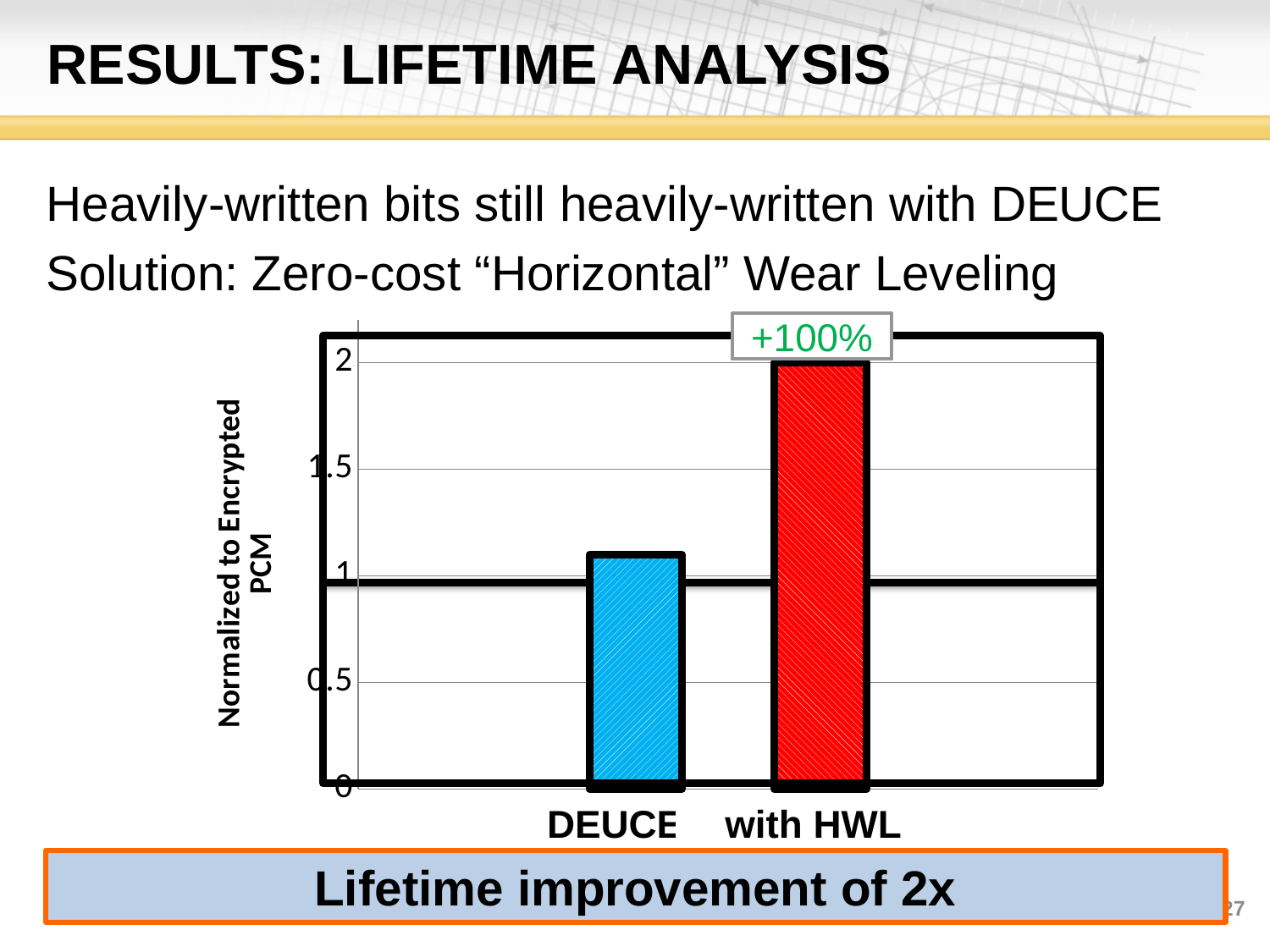
What kind of chart is shown on the slide? bar chart What is the label on the vertical axis of the chart? Normalized to Encrypted PCM What annotation is printed above the with HWL bar? +100% Do the bar values rise or fall going from DEUCE to with HWL? rise Is the value for with HWL greater or less than 1.5? greater Which bar is taller, DEUCE or with HWL? with HWL How many bars are plotted in the chart? 2 Which category has the lowest bar in the chart? DEUCE Is the value for DEUCE greater or less than 1.5? less Is the value for DEUCE greater or less than 0.5? greater Which category has the highest bar in the chart? with HWL